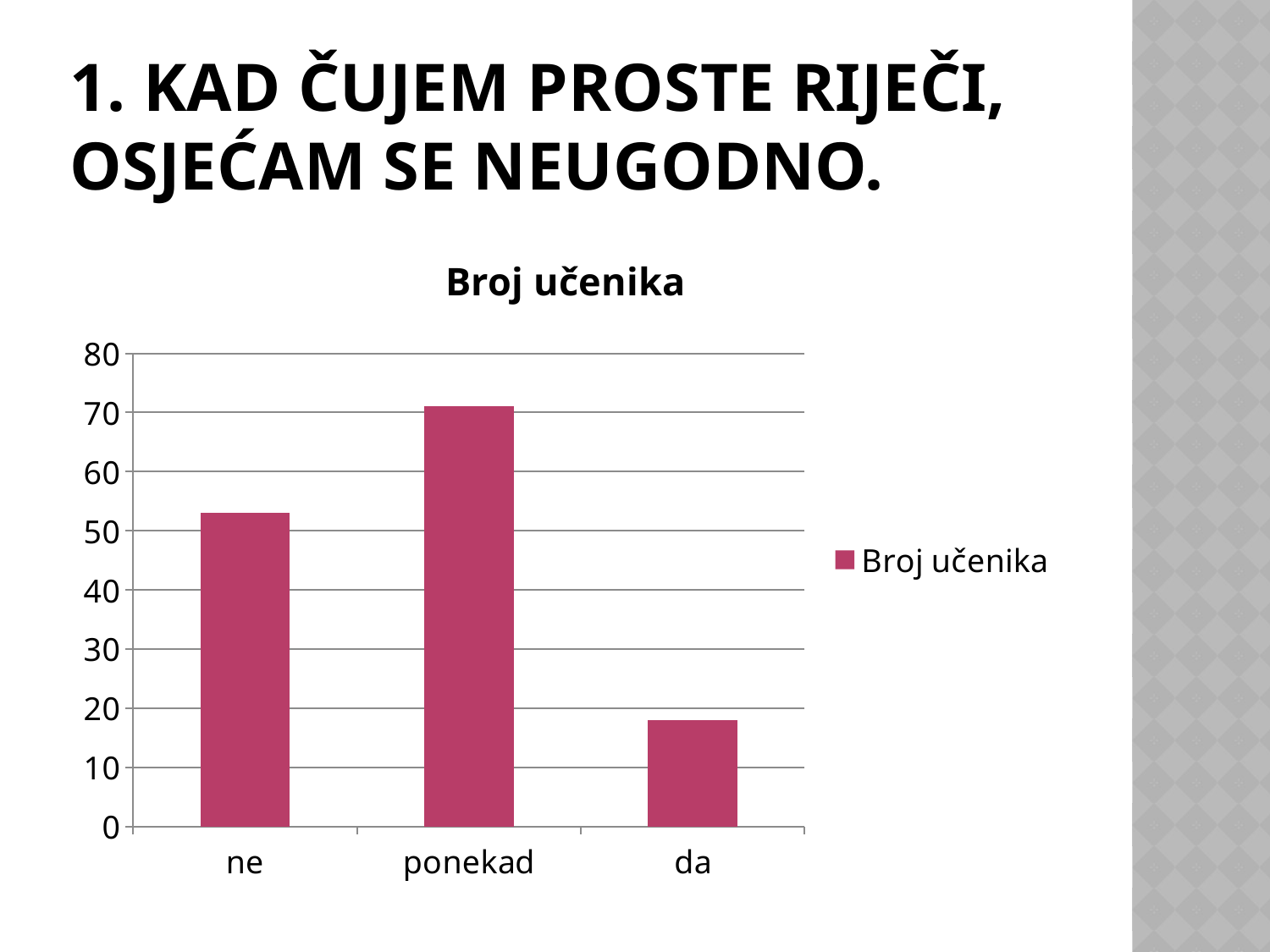
Is the value for da greater or less than 30? less How many categories are shown on the x axis of the chart? 3 What is the title of the chart? Broj učenika What is the name of the series shown in the legend? Broj učenika Is the value for ponekad greater or less than 60? greater What kind of chart is shown on the slide? bar chart Which is larger, the value for ne or the value for da? ne How many series does the chart legend list? 1 Is the value for ne greater or less than 40? greater Which category has the lowest value in the chart? da Which is larger, the value for ponekad or the value for ne? ponekad Which category has the highest value in the chart? ponekad